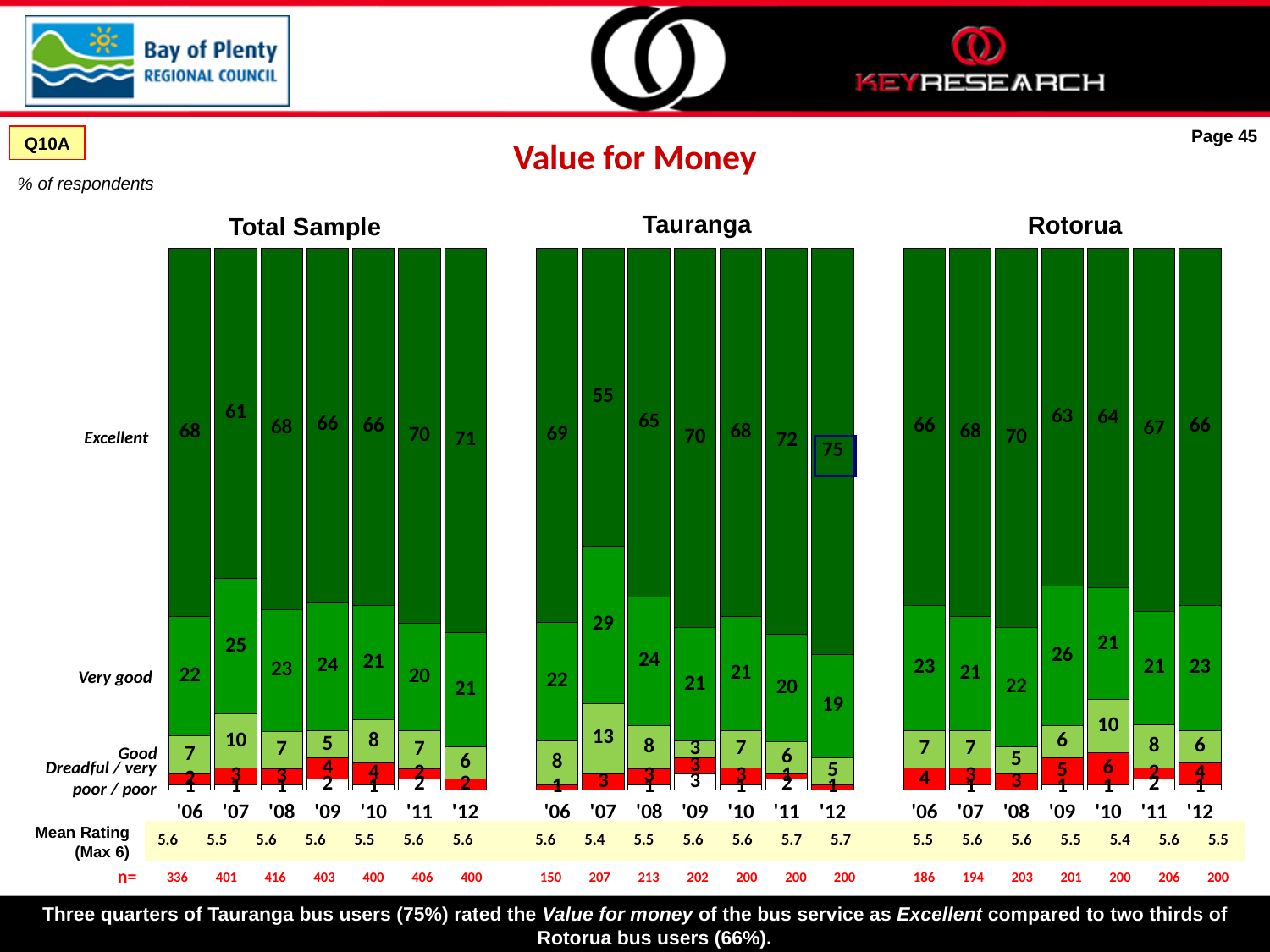
In the Tauranga chart, which year has the highest Very good percentage? '07 In the Rotorua chart, what is the Very good percentage for '09? 26 What kind of chart is the Tauranga chart? Stacked bar chart In the Tauranga chart, what percentage of respondents rated value for money as Excellent in '12? 75 How many years are shown on the x axis of the Total Sample chart? 7 In the Tauranga chart, what is the difference between the Excellent percentage in '12 and in '07? 20 What is the title of the slide's charts? Value for Money In the Tauranga chart, does the Excellent percentage rise or fall from '07 to '12? Rise In the Total Sample chart, which year has the highest Excellent percentage? '12 For '08, is the Excellent percentage higher in the Rotorua chart or the Tauranga chart? Rotorua In the Rotorua chart, what is the Good percentage for '10? 10 In the Tauranga chart, which year has the lowest Excellent percentage? '07